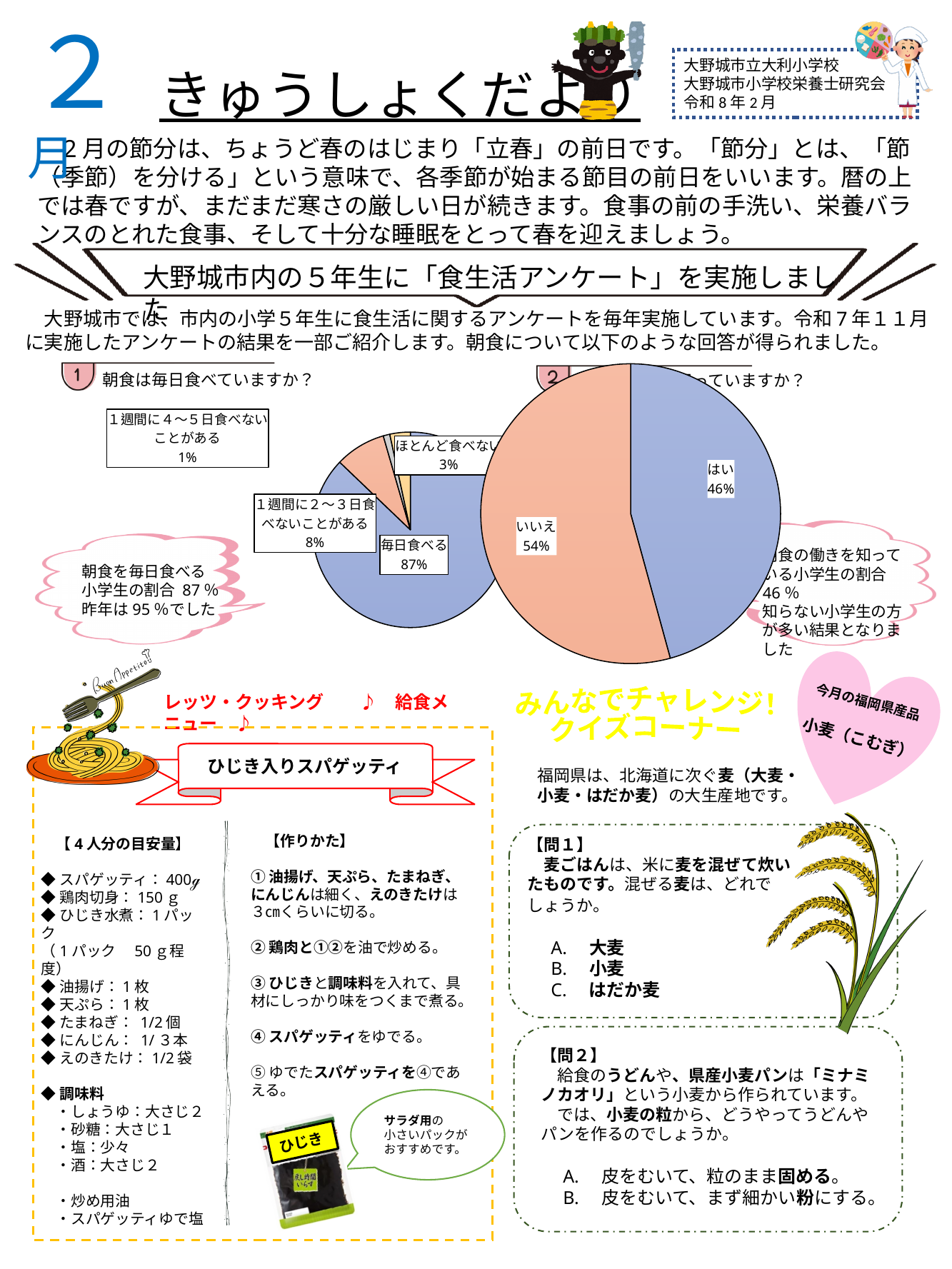
In the pie chart 「朝食は毎日食べていますか？」, what percentage is shown for 「毎日食べる」? 87% In the pie chart 「朝食は毎日食べていますか？」, which category has the largest share? 毎日食べる How many categories are shown in the pie chart 「朝食は毎日食べていますか？」? 4 In the right pie chart, what percentage is shown for 「いいえ」? 54% In the pie chart 「朝食は毎日食べていますか？」, what is the difference in percentage points between 「毎日食べる」 and 「1週間に2〜3日食べないことがある」? 79 In the pie chart 「朝食は毎日食べていますか？」, what percentage is shown for 「1週間に2〜3日食べないことがある」? 8% How many slices does the right pie chart have? 2 In the right pie chart, what percentage is shown for 「はい」? 46% What kind of chart is used for the question 「朝食は毎日食べていますか？」? pie chart In the right pie chart, which is larger, 「はい」 or 「いいえ」? いいえ In the pie chart 「朝食は毎日食べていますか？」, which category has the smallest share? 1週間に4〜5日食べないことがある In the pie chart 「朝食は毎日食べていますか？」, what percentage is shown for 「ほとんど食べない」? 3%